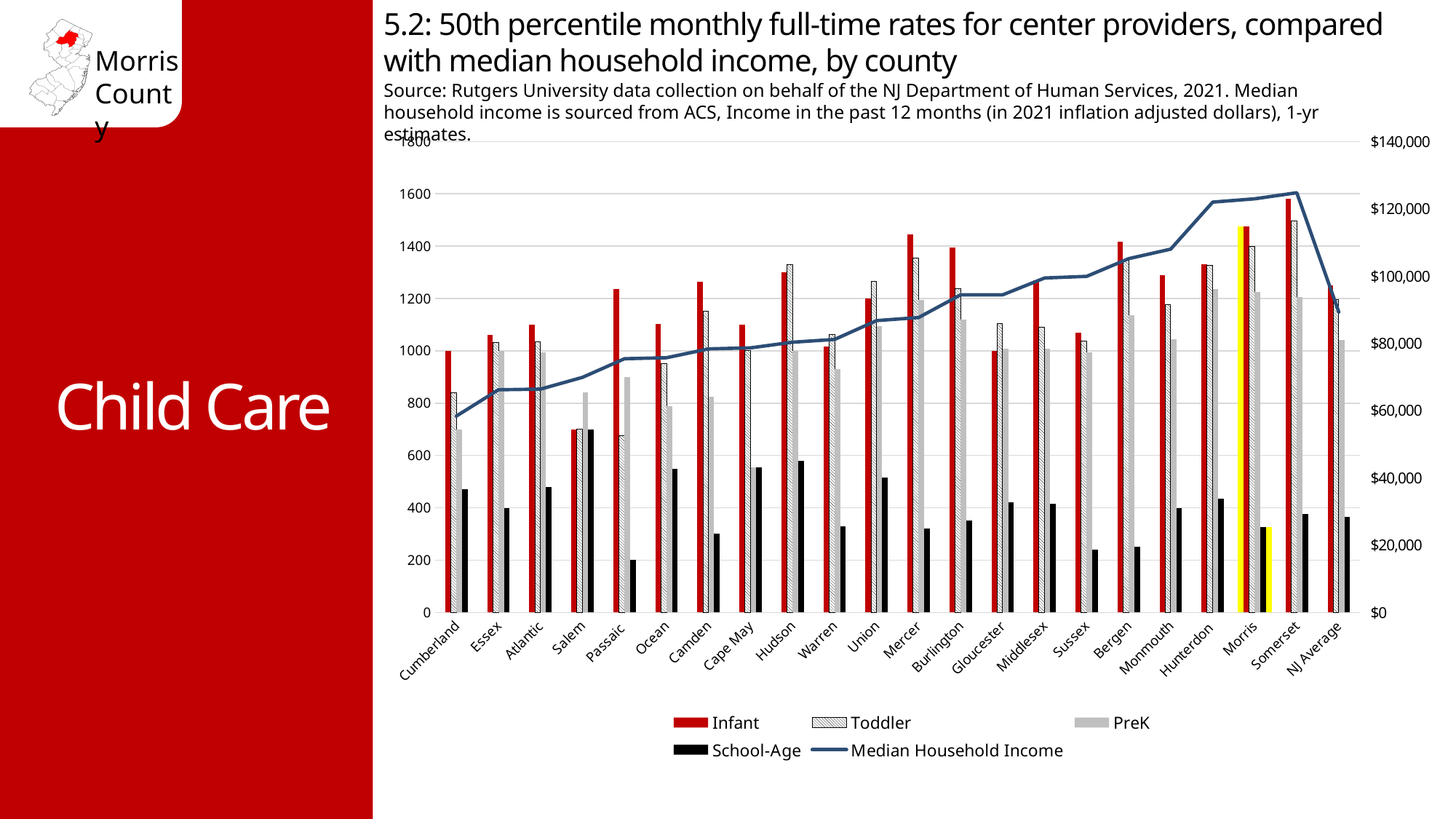
Is the Median Household Income for Cumberland greater or less than $80,000? less Is the Infant rate for Somerset greater or less than 1400? greater What kind of chart is shown on the slide? Combination bar and line chart Which county has the highest School-Age rate? Salem Which is larger, the Toddler rate for Hudson or the Toddler rate for Salem? Hudson Which county's bars are highlighted in yellow on the chart? Morris Which county has the lowest School-Age rate? Passaic How many series does the chart legend list? 5 How many categories are shown along the x axis of the chart? 22 Which county has the lowest Median Household Income? Cumberland Does the Median Household Income line generally rise or fall from Cumberland to Somerset? rise Which county has the highest Infant rate? Somerset